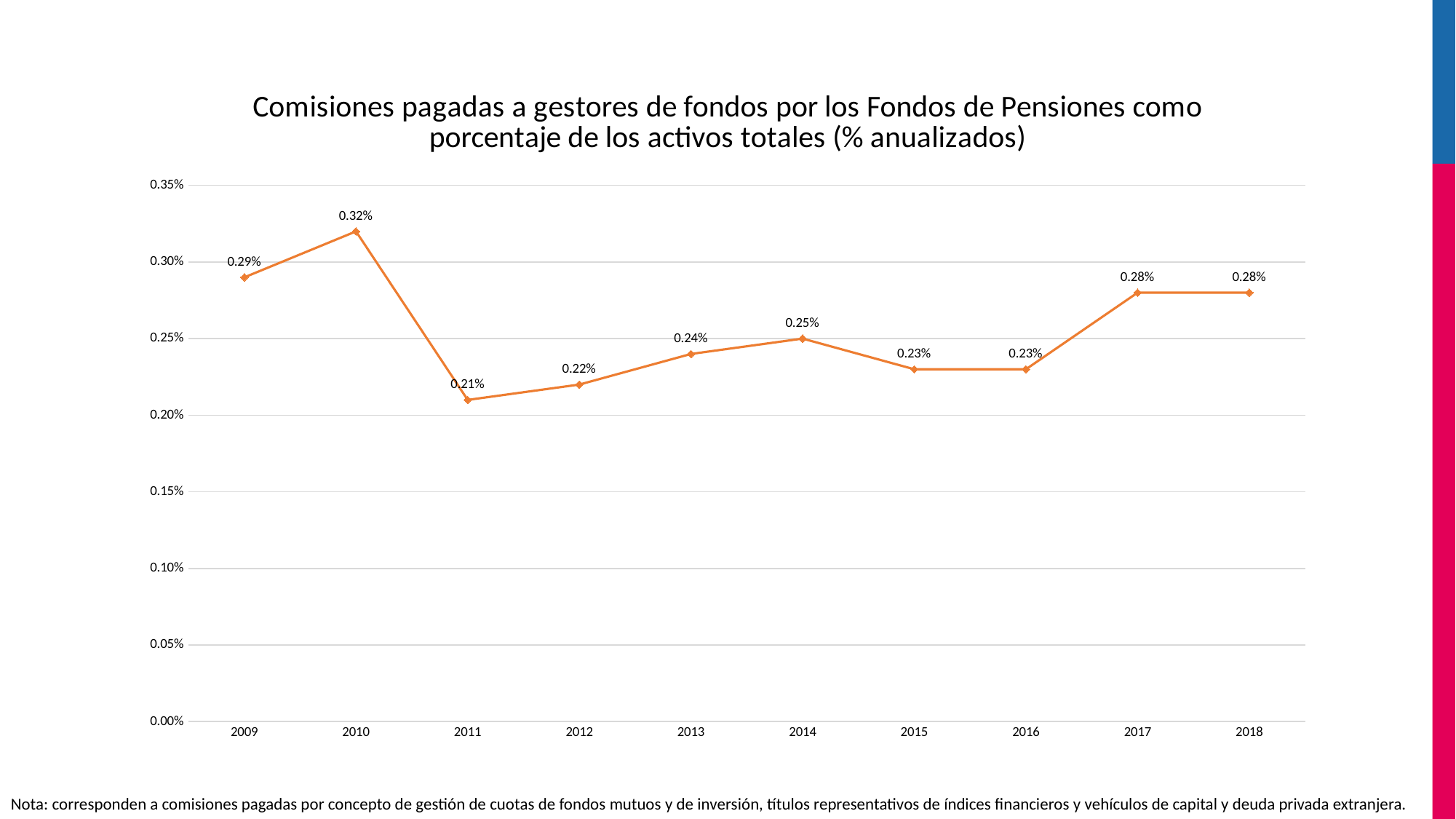
Which year has the lowest value? 2011 Which year has the highest value? 2010 What is the value for 2014? 0.25% How many years are plotted on the x axis? 10 Which is larger, the value for 2009 or the value for 2013? 2009 What is the value for 2018? 0.28% Is the value for 2017 greater or less than 0.25%? greater What is the difference between the values for 2010 and 2011? 0.11% Do the values rise or fall from 2014 to 2015? fall What is the value for 2011? 0.21% What is the value for 2010? 0.32% What kind of chart is this? line chart